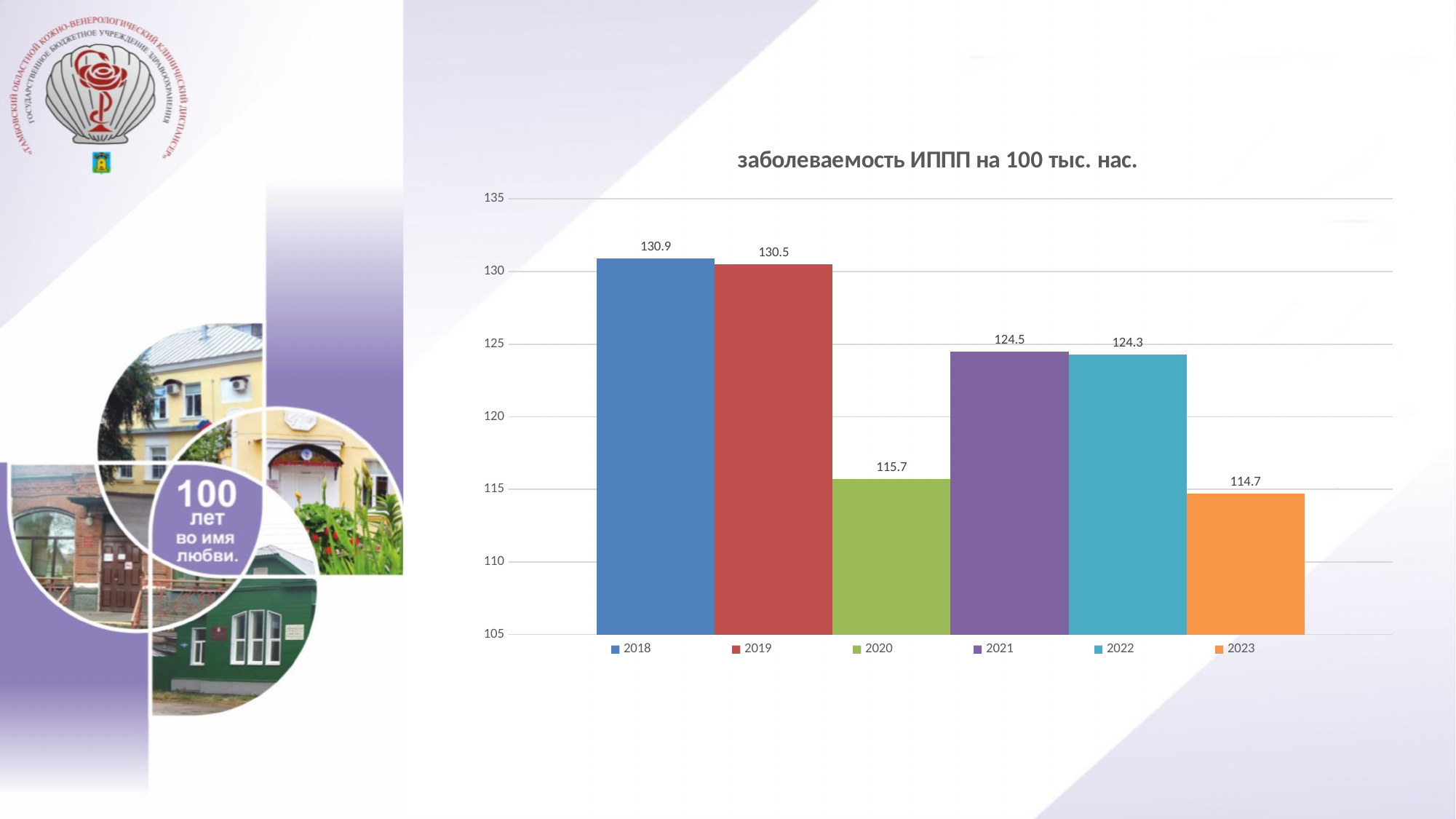
What is the value for 2018? 130.9 Which is larger, the value for 2021 or the value for 2020? 2021 What is the difference between the values for 2018 and 2023? 16.2 What is the value for 2020? 115.7 What kind of chart is shown on the slide? bar chart What is the title of the chart? заболеваемость ИППП на 100 тыс. нас. How many bars are shown in the chart? 6 Is the value for 2022 greater or less than 120? greater What is the value for 2023? 114.7 What is the difference between the values for 2021 and 2020? 8.8 Which year has the highest value? 2018 Which year has the lowest value? 2023